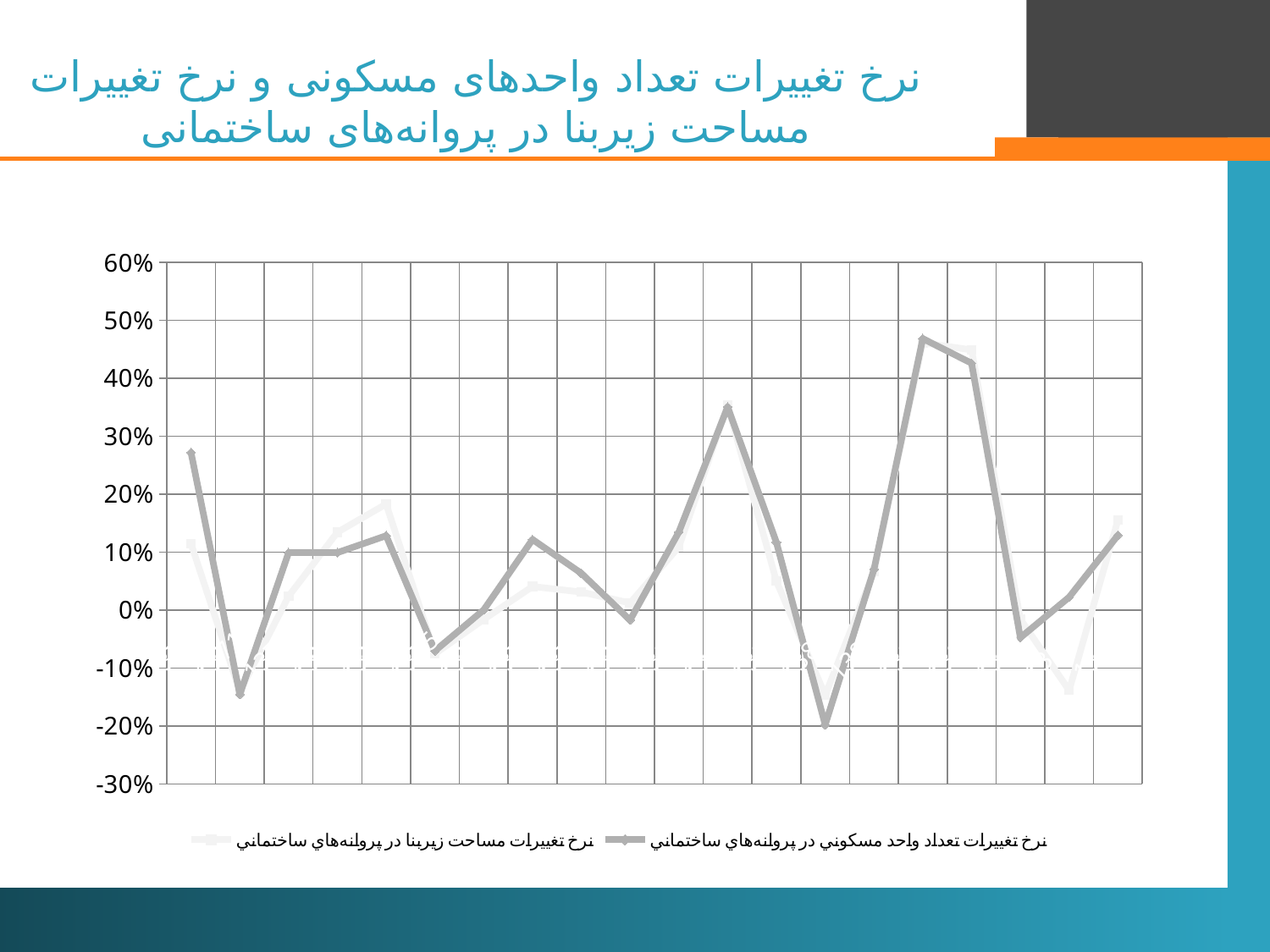
Does the series نرخ تغییرات مساحت زیربنا در پروانه‌های ساختمانی end higher or lower than it starts? higher Is the lowest point of the series نرخ تغییرات مساحت زیربنا در پروانه‌های ساختمانی greater or less than -10%? less Is the highest point of the series نرخ تغییرات مساحت زیربنا در پروانه‌های ساختمانی greater or less than 40%? greater How many series does the legend list? 2 What is the lowest value shown on the vertical axis? -30% What is the highest value shown on the vertical axis? 60% Is the highest point of the series نرخ تغییرات تعداد واحد مسکونی در پروانه‌های ساختمانی greater or less than 30%? greater Does the series نرخ تغییرات مساحت زیربنا در پروانه‌های ساختمانی rise or fall between its first and second points? fall Which series reaches the lower minimum value, نرخ تغییرات مساحت زیربنا or نرخ تغییرات تعداد واحد مسکونی? نرخ تغییرات تعداد واحد مسکونی در پروانه‌های ساختمانی What kind of chart is shown on the slide? line chart